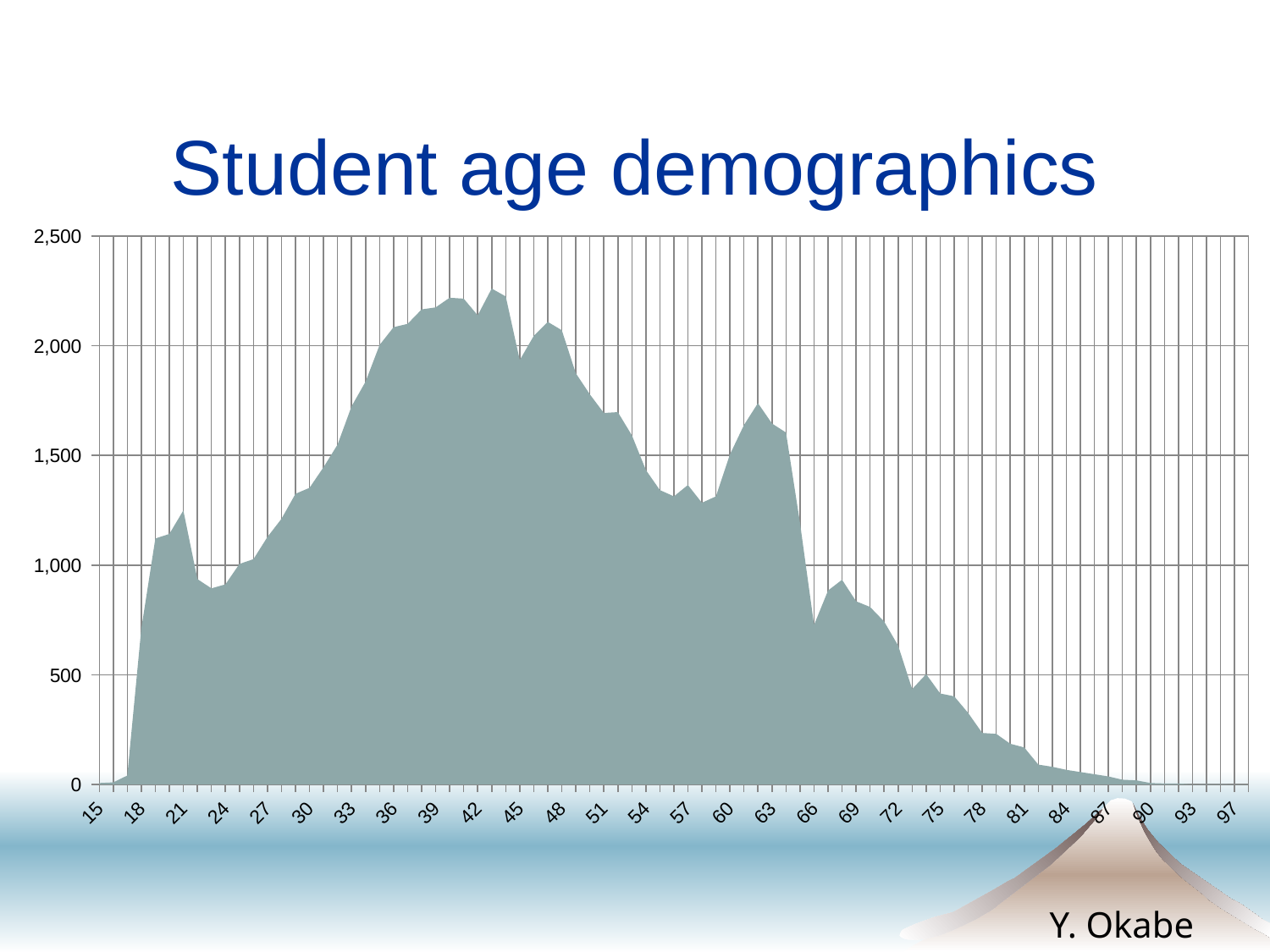
Do the values rise or fall along the x axis from age 66 to age 97? fall Which has the larger value, age 21 or age 24? age 21 Is the value for age 24 greater or less than 1,000? less Which has the larger value, age 42 or age 63? age 42 What kind of chart is shown on the slide? area chart What is the highest value shown on the vertical axis? 2,500 Is the value for age 63 greater or less than 1,500? greater Is the value for age 84 greater or less than 500? less What is the title of the chart? Student age demographics